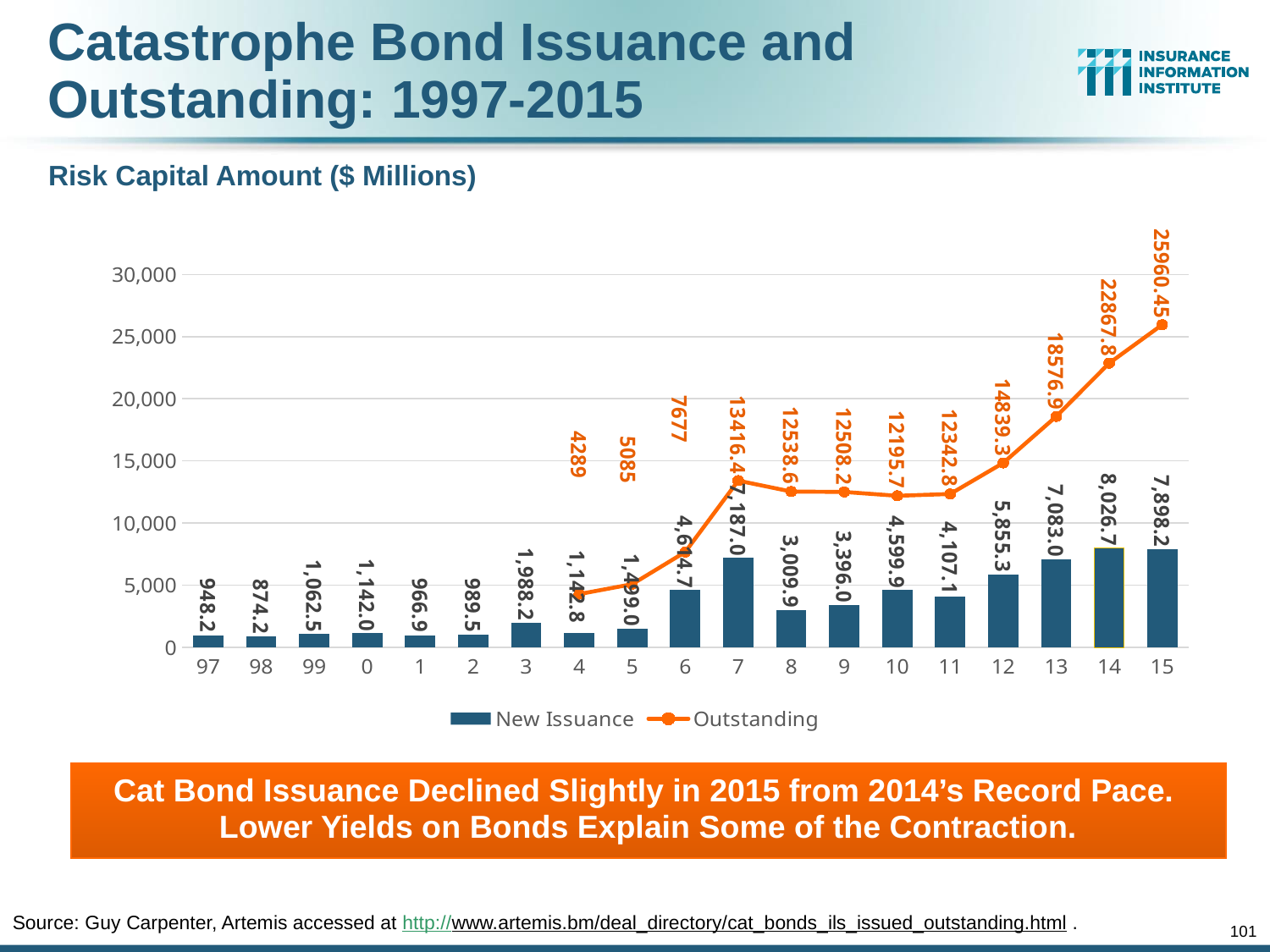
Which year has the lowest New Issuance value? 98 What is the New Issuance value for 14? 8,026.7 Is the Outstanding value for 13 greater or less than 15,000? greater Does the Outstanding series rise or fall from 12 to 15? rise What kind of chart is shown on the slide? bar and line chart How many years are shown on the x axis? 19 What is the Outstanding value for 7? 13416.4 What is the difference between the New Issuance values for 14 and 15? 128.5 How many series does the legend list? 2 Which is larger, the New Issuance value for 7 or for 13? 7 Which year has the highest New Issuance value? 14 What is the Outstanding value for 15? 25960.45